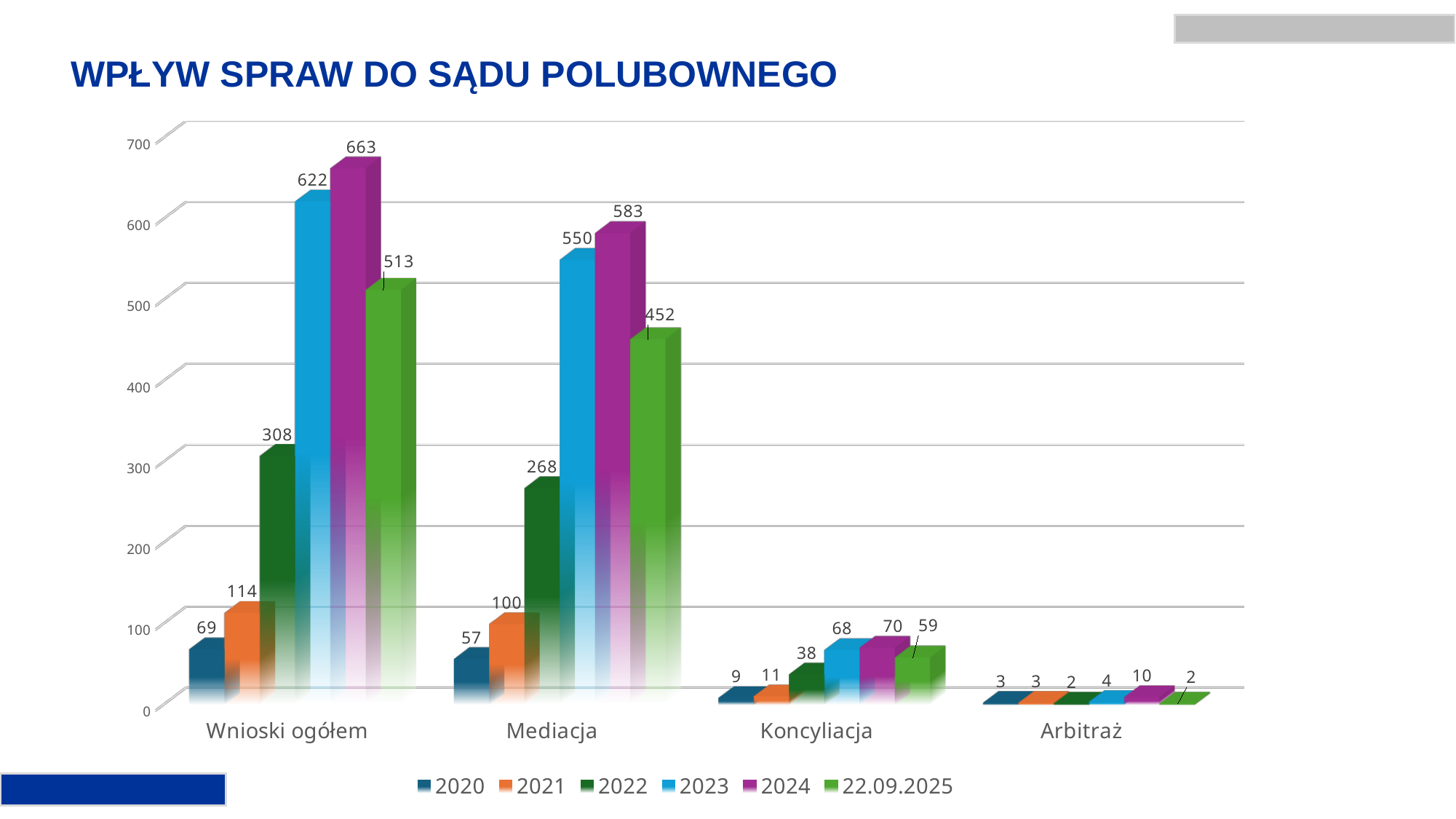
What is the value for 2024 in the Wnioski ogółem category? 663 Which year has the highest value in the Mediacja category? 2024 What is the value for 22.09.2025 in the Koncyliacja category? 59 What is the value for 2024 in the Arbitraż category? 10 What is the value for 2022 in the Mediacja category? 268 Which year has the lowest value in the Koncyliacja category? 2020 What is the title of the chart? WPŁYW SPRAW DO SĄDU POLUBOWNEGO What is the difference between the 2023 and 2022 values in the Wnioski ogółem category? 314 Which is larger: the 2021 value for Mediacja or the 2021 value for Wnioski ogółem? Wnioski ogółem What kind of chart is shown on the slide? Bar chart How many categories are shown on the x axis? 4 How many series does the legend list? 6